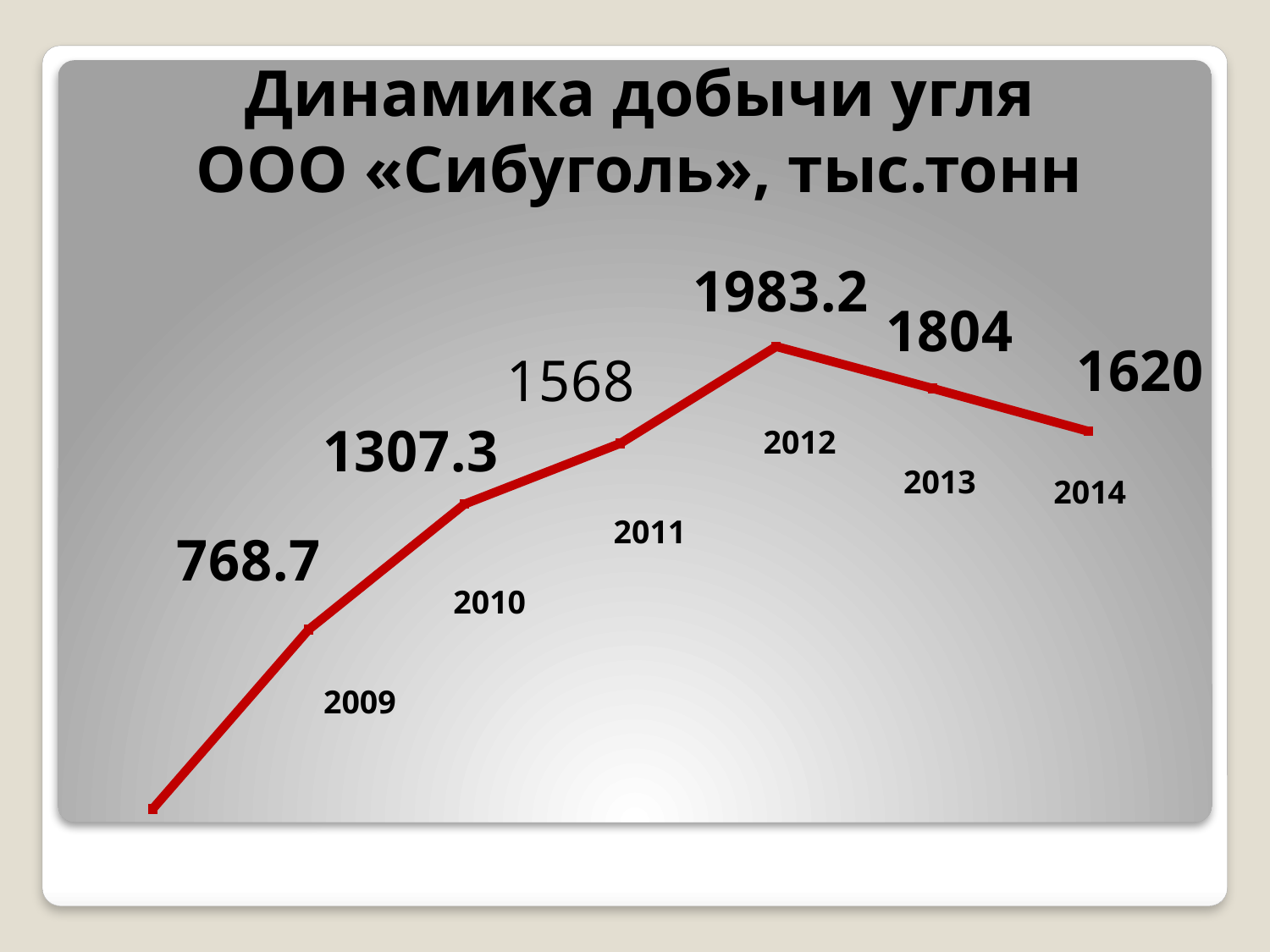
What is the difference between the values for 2012 and 2013? 179.2 What is the difference between the values for 2010 and 2009? 538.6 What was the coal production value for 2014? 1620 What is the difference between the values for 2013 and 2014? 184 Which year has the highest coal production value on the chart? 2012 Do the values rise or fall from 2012 to 2014? Fall What was the coal production value for 2009? 768.7 Among the labeled years, which has the lowest coal production value? 2009 What kind of chart is shown on the slide? Line chart What was the coal production value for 2011? 1568 Which year has the larger value, 2013 or 2014? 2013 What was the coal production value for 2012? 1983.2